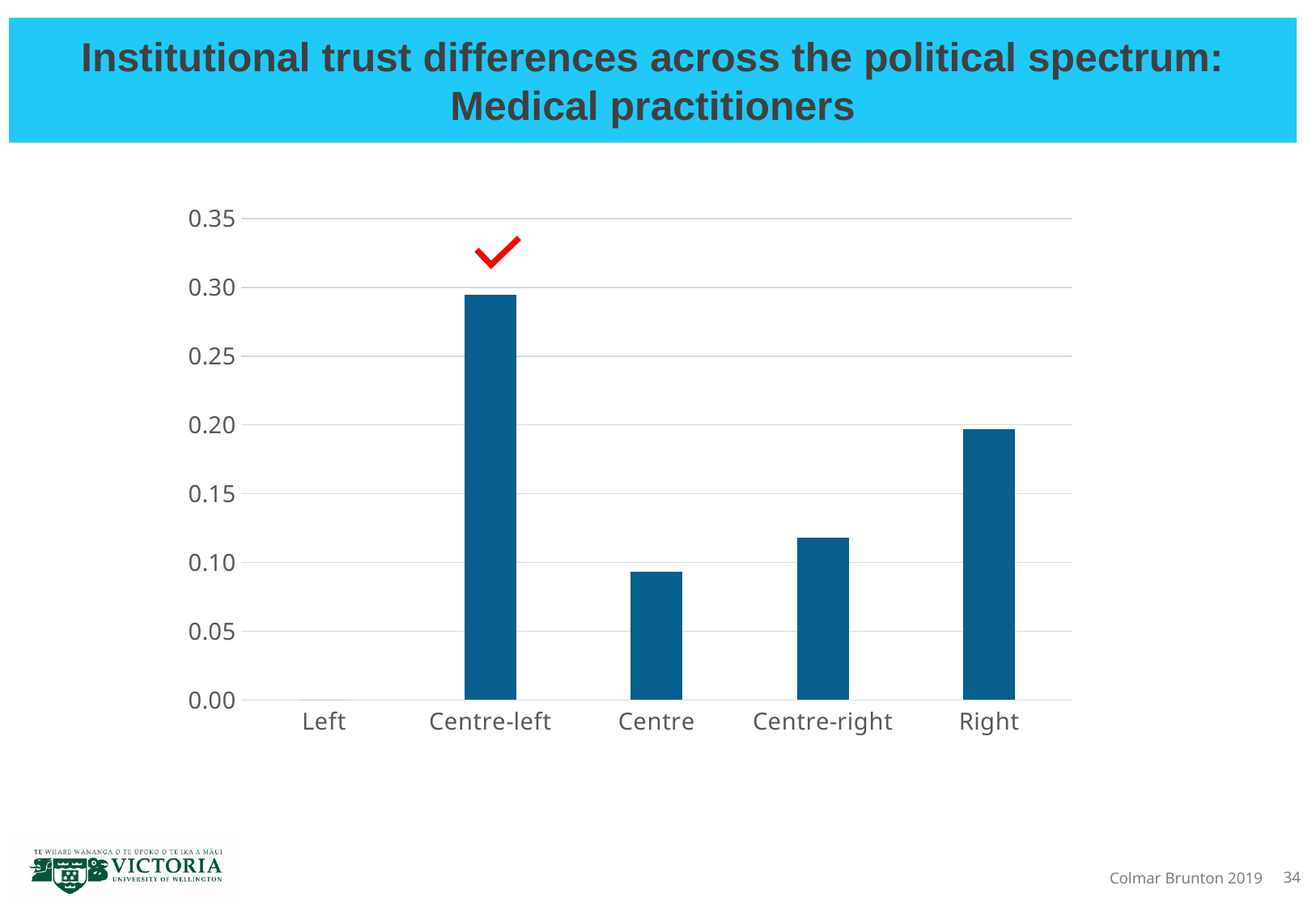
How many political categories are shown on the x axis? 5 Is the value for Centre greater or less than 0.15? less Above which bar is a red check mark placed? Centre-left Which has a larger value, Centre or Centre-right? Centre-right Is the value for Centre-right greater or less than 0.10? greater Which political category has the highest value? Centre-left Is the value for Centre-left greater or less than 0.25? greater What kind of chart is shown on the slide? Bar chart Which has a larger value, Right or Centre-right? Right What is the title of the slide? Institutional trust differences across the political spectrum: Medical practitioners Which political category has the lowest value? Left